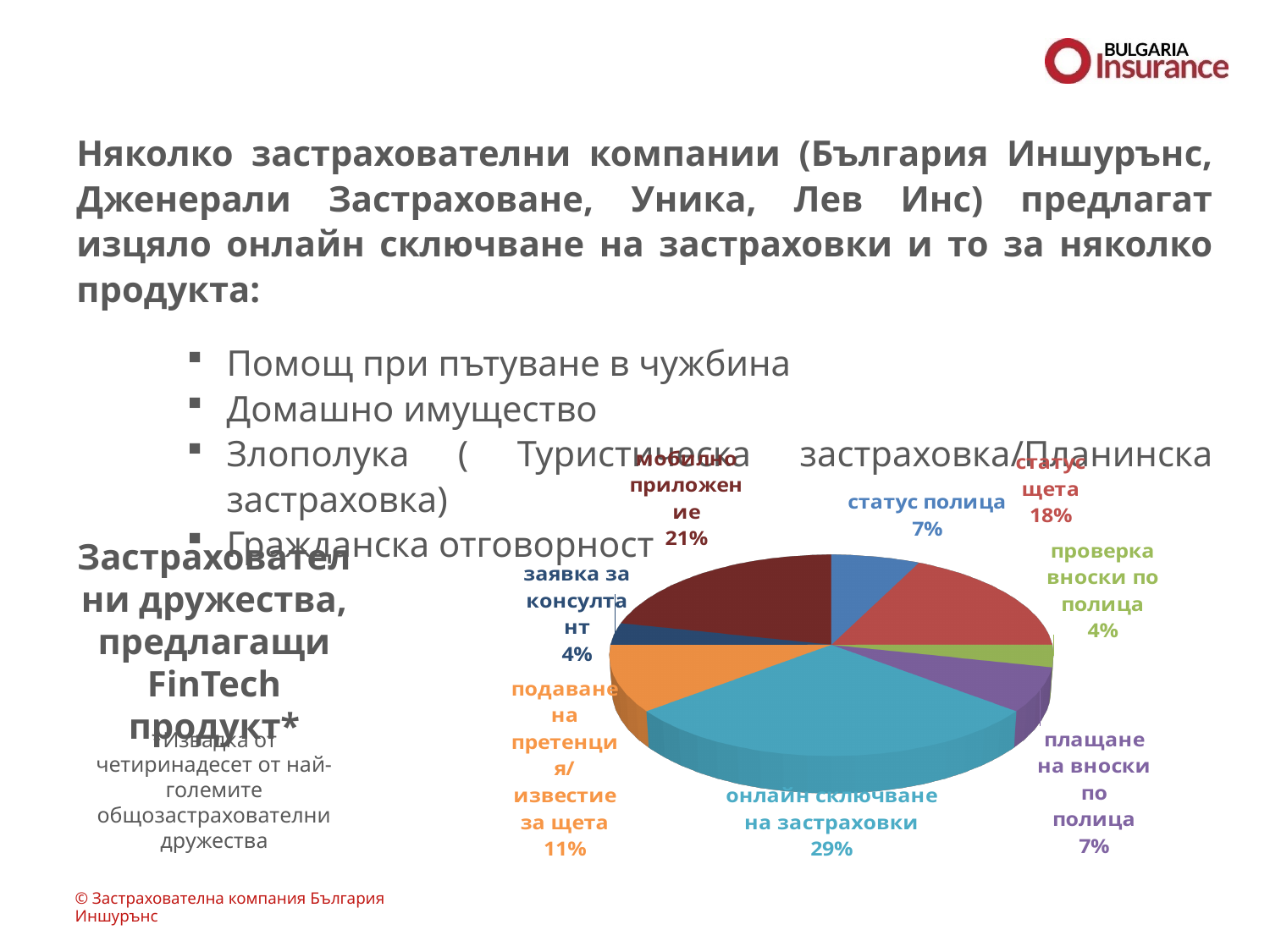
Which category has the largest slice of the pie? онлайн сключване на застраховки Which is larger: the slice for "статус щета" or the slice for "статус полица"? статус щета What type of chart is shown on the slide? pie chart What is the title of the chart? Застрахователни дружества, предлагащи FinTech продукт* What share of the pie does "мобилно приложение" have? 21% What is the difference in percentage points between "онлайн сключване на застраховки" and "мобилно приложение"? 8 What share of the pie does "статус щета" have? 18% What share of the pie does "проверка вноски по полица" have? 4% What share of the pie does "подаване на претенция/известие за щета" have? 11% How many slices does the pie chart have? 8 What share of the pie does "онлайн сключване на застраховки" have? 29% What is the difference in percentage points between "статус щета" and "подаване на претенция/известие за щета"? 7